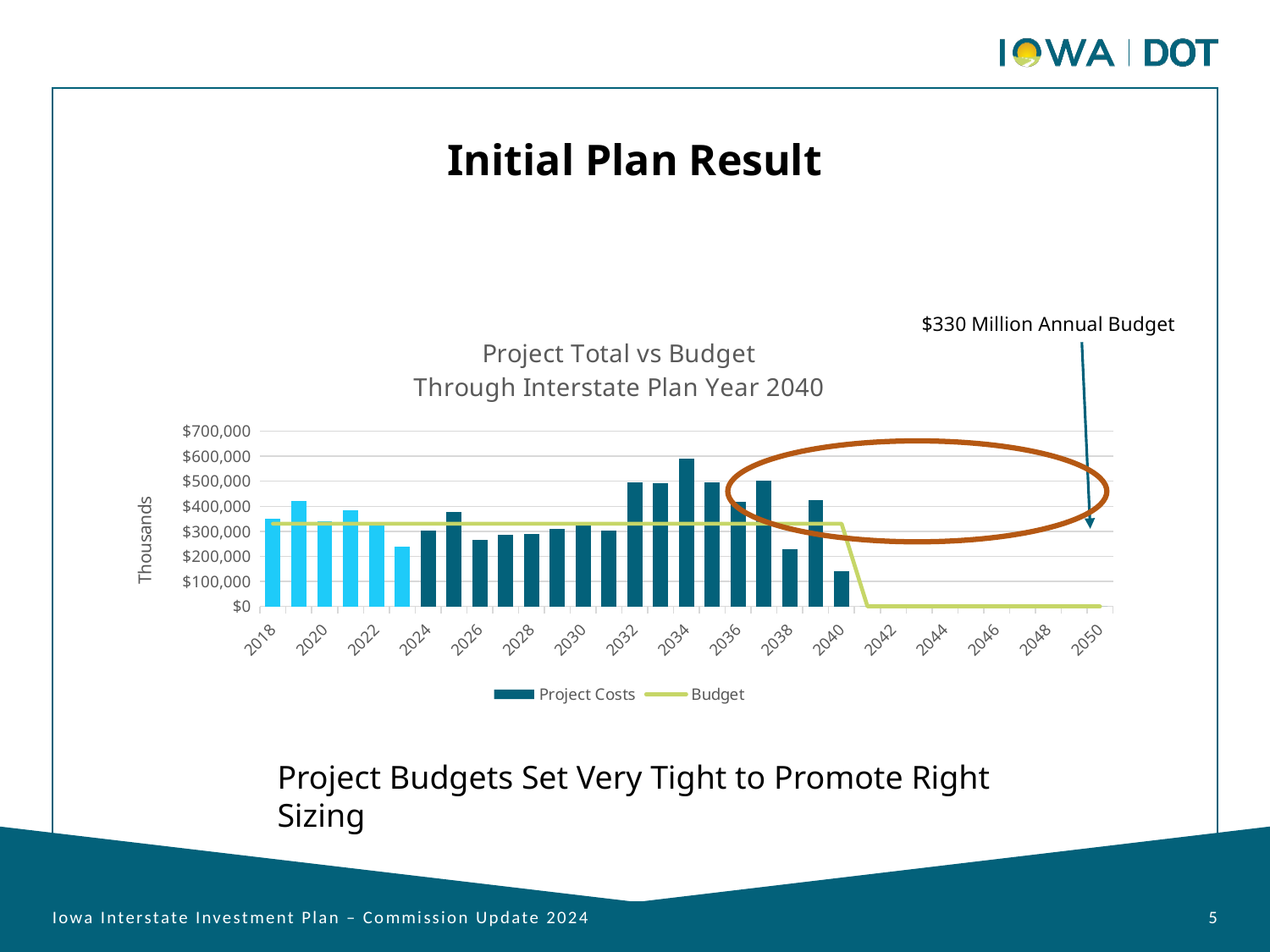
Is the Project Costs value for 2034 greater or less than $500,000? greater How many Project Costs bars are plotted on the chart? 23 Which year has the highest Project Costs bar? 2034 What is the title of the chart? Project Total vs Budget Through Interstate Plan Year 2040 How many series does the chart legend list? 2 Which year has larger Project Costs, 2019 or 2023? 2019 Is the Project Costs value for 2040 greater or less than $200,000? less Does the Budget line rise or fall between 2040 and 2042? Fall What annual budget does the annotation above the chart state? $330 Million Annual Budget What kind of chart is used to show Project Costs? Bar chart Is the Project Costs value for 2023 greater or less than $300,000? less Which year has the lowest Project Costs bar? 2040